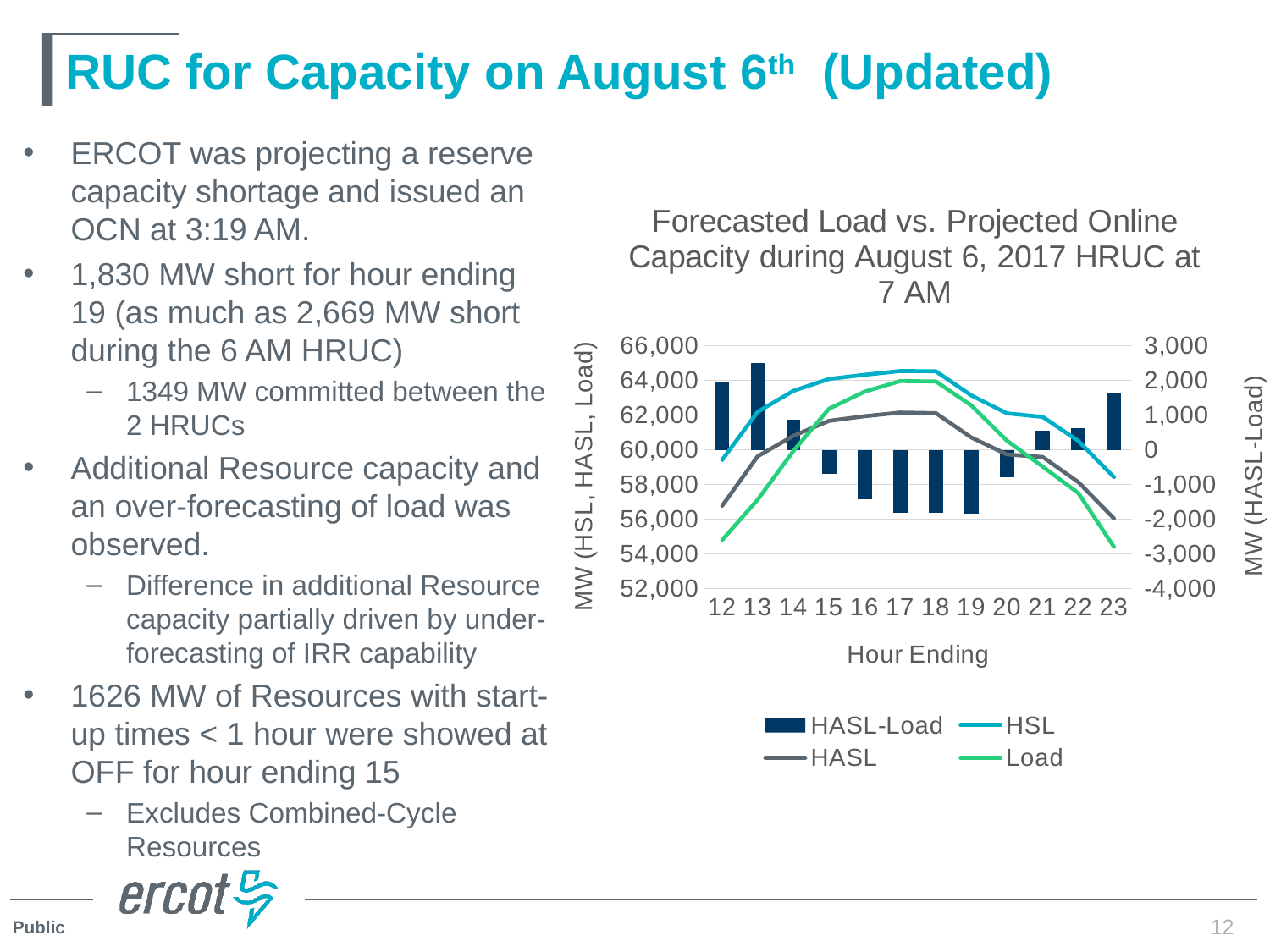
Does the Load line rise or fall from hour ending 12 to hour ending 17? rise For which hour ending is the HASL-Load bar the highest? 13 Is the HASL-Load value for hour ending 13 greater or less than 2,000? greater Is the HSL value for hour ending 17 greater or less than 64,000? greater What kind of chart is shown on the slide? Combined bar and line chart How many series does the chart legend list? 4 At hour ending 12, which is larger, HSL or Load? HSL Which series in the chart is plotted as bars? HASL-Load Is the HSL value for hour ending 23 greater or less than 60,000? less What is the title of the chart on the slide? Forecasted Load vs. Projected Online Capacity during August 6, 2017 HRUC at 7 AM How many hour-ending categories are shown on the x axis of the chart? 12